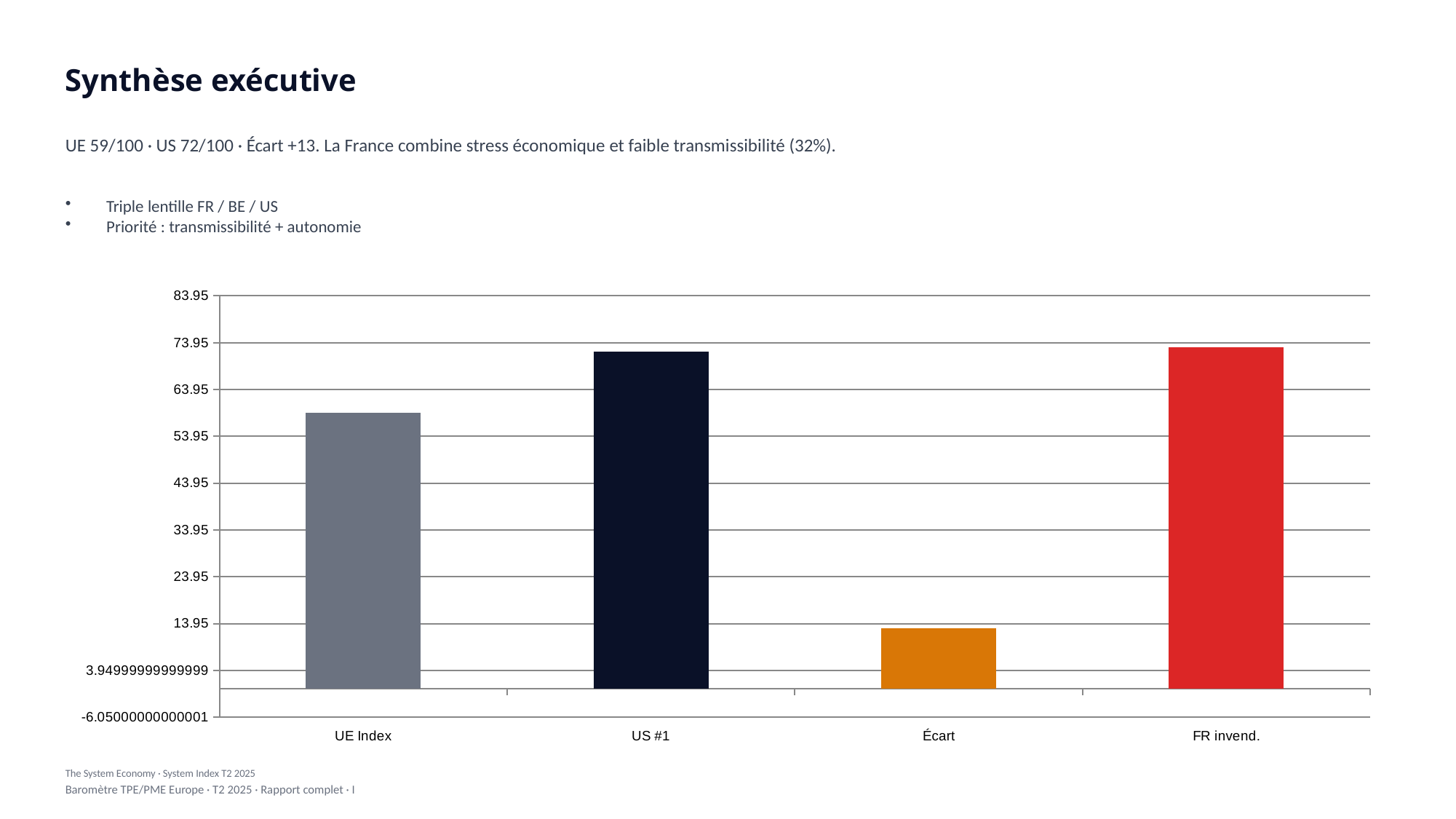
Which category has the lowest value on the chart? Écart Is the value for FR invend. greater or less than 63.95? greater Is the value for UE Index greater or less than 63.95? less Is the value for US #1 greater or less than 63.95? greater What kind of chart is shown on the slide? bar chart What is the label of the last category on the x axis? FR invend. Which is larger on the chart, the value for Écart or the value for UE Index? UE Index How many categories are plotted on the chart? 4 Which is larger on the chart, the value for UE Index or the value for US #1? US #1 What colour is the bar for Écart? orange